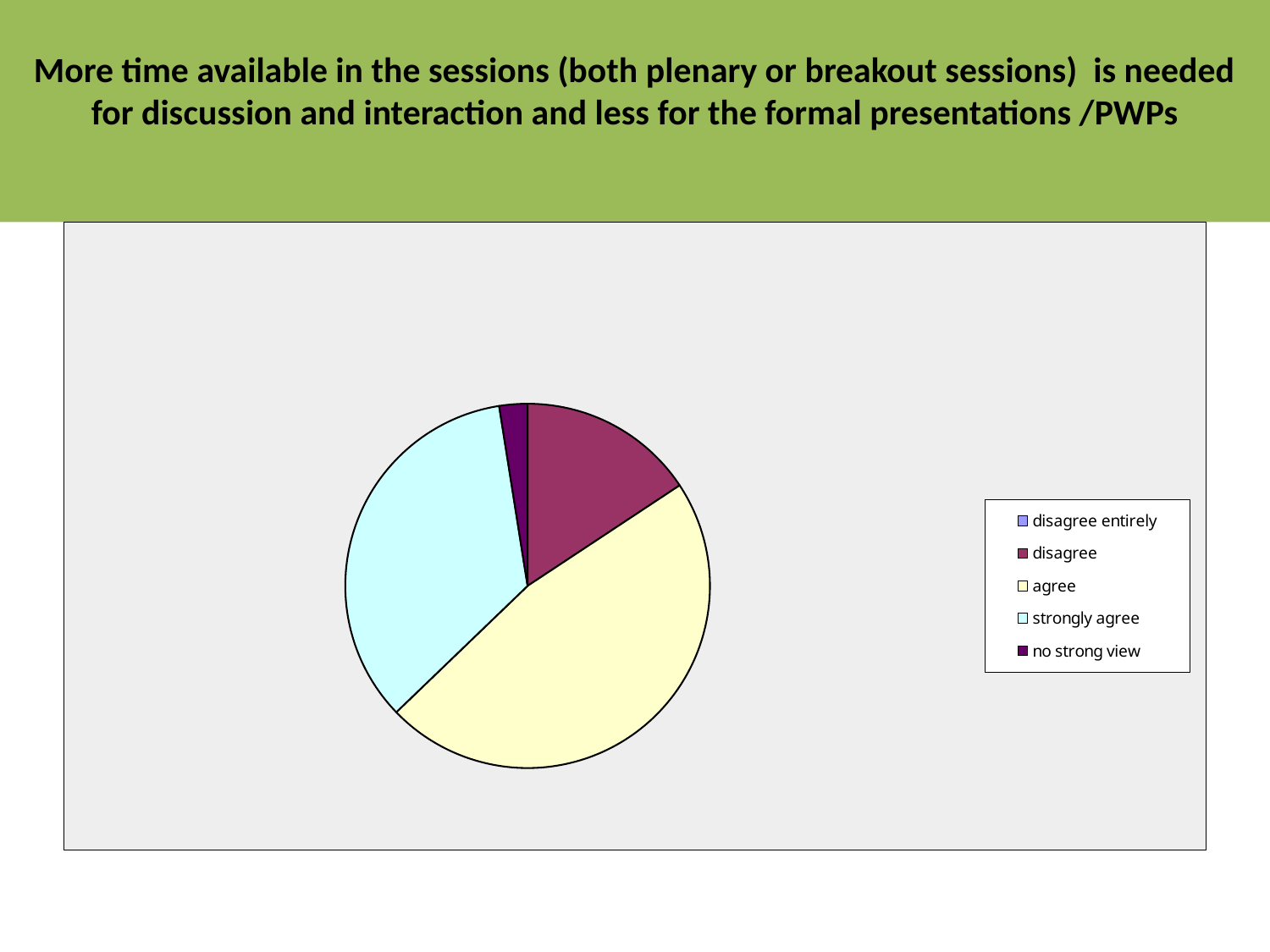
Which of the visible slices is the smallest? no strong view Which slice is larger, disagree or no strong view? disagree What colour is the slice for agree? light yellow Which category has the largest slice of the pie? agree Which slice is larger, strongly agree or disagree? strongly agree How many slices are visible in the pie? 4 Which slice is larger, agree or strongly agree? agree How many entries does the legend list? 5 What kind of chart is shown on the slide? pie chart Which legend entry has no visible slice in the pie? disagree entirely